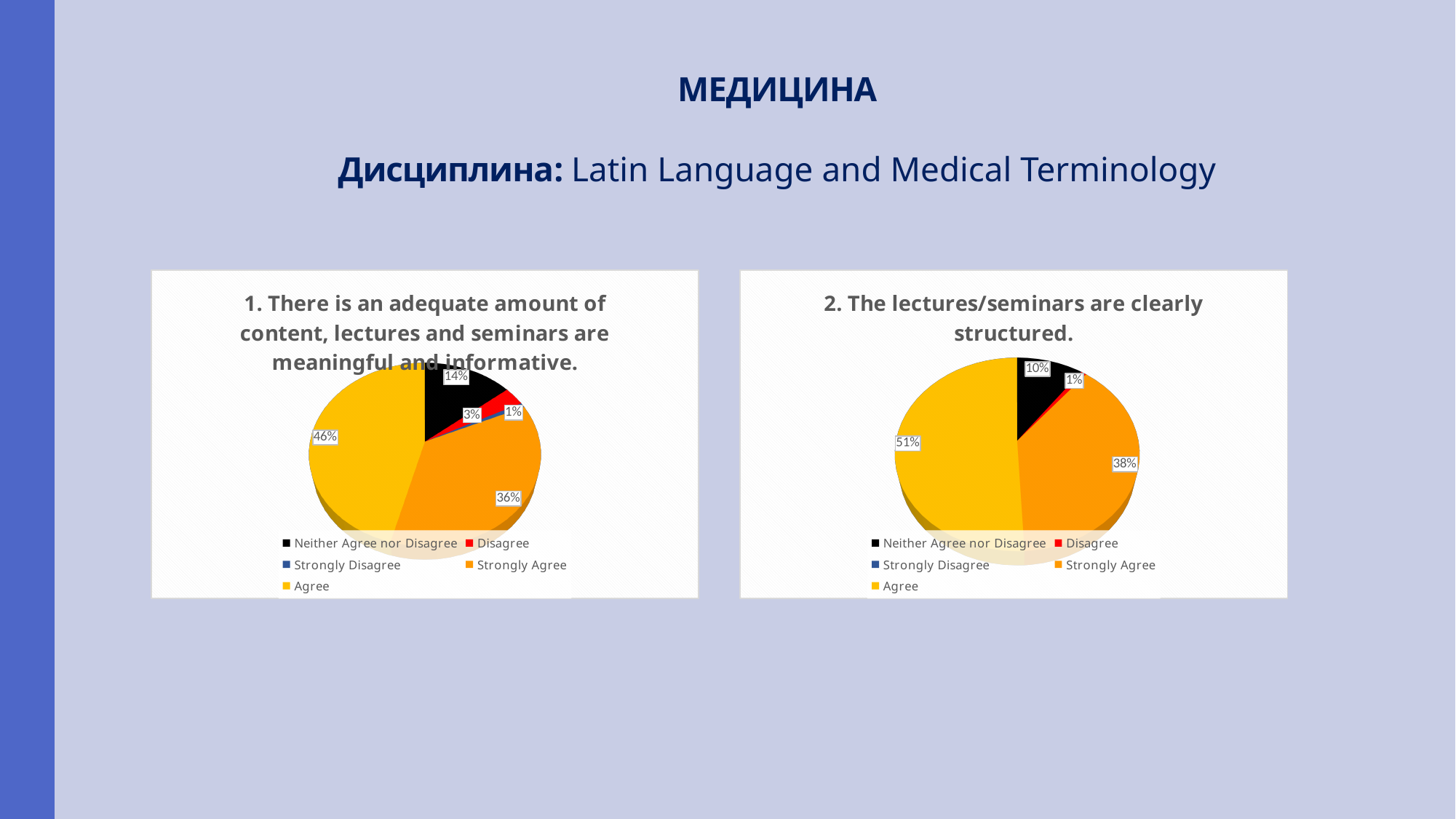
In the left chart ("1. There is an adequate amount of content..."), which category has the largest slice? Agree In the left chart ("1. There is an adequate amount of content..."), what share of the pie is Strongly Agree? 36% In the left chart ("1. There is an adequate amount of content..."), what share of the pie is Disagree? 3% In the left chart ("1. There is an adequate amount of content..."), what is the difference between the Agree and Strongly Agree shares? 10% In the left chart ("1. There is an adequate amount of content..."), what share of the pie is Neither Agree nor Disagree? 14% In the right chart ("2. The lectures/seminars are clearly structured."), what share of the pie is Agree? 51% In the right chart ("2. The lectures/seminars are clearly structured."), which category has the largest slice? Agree In the right chart ("2. The lectures/seminars are clearly structured."), what share of the pie is Neither Agree nor Disagree? 10% In the left chart ("1. There is an adequate amount of content, lectures and seminars are meaningful and informative."), what share of the pie is Agree? 46% How many categories does the legend of the right chart ("2. The lectures/seminars are clearly structured.") list? 5 In the right chart ("2. The lectures/seminars are clearly structured."), what share of the pie is Strongly Agree? 38% What kind of chart is used on this slide? Pie chart